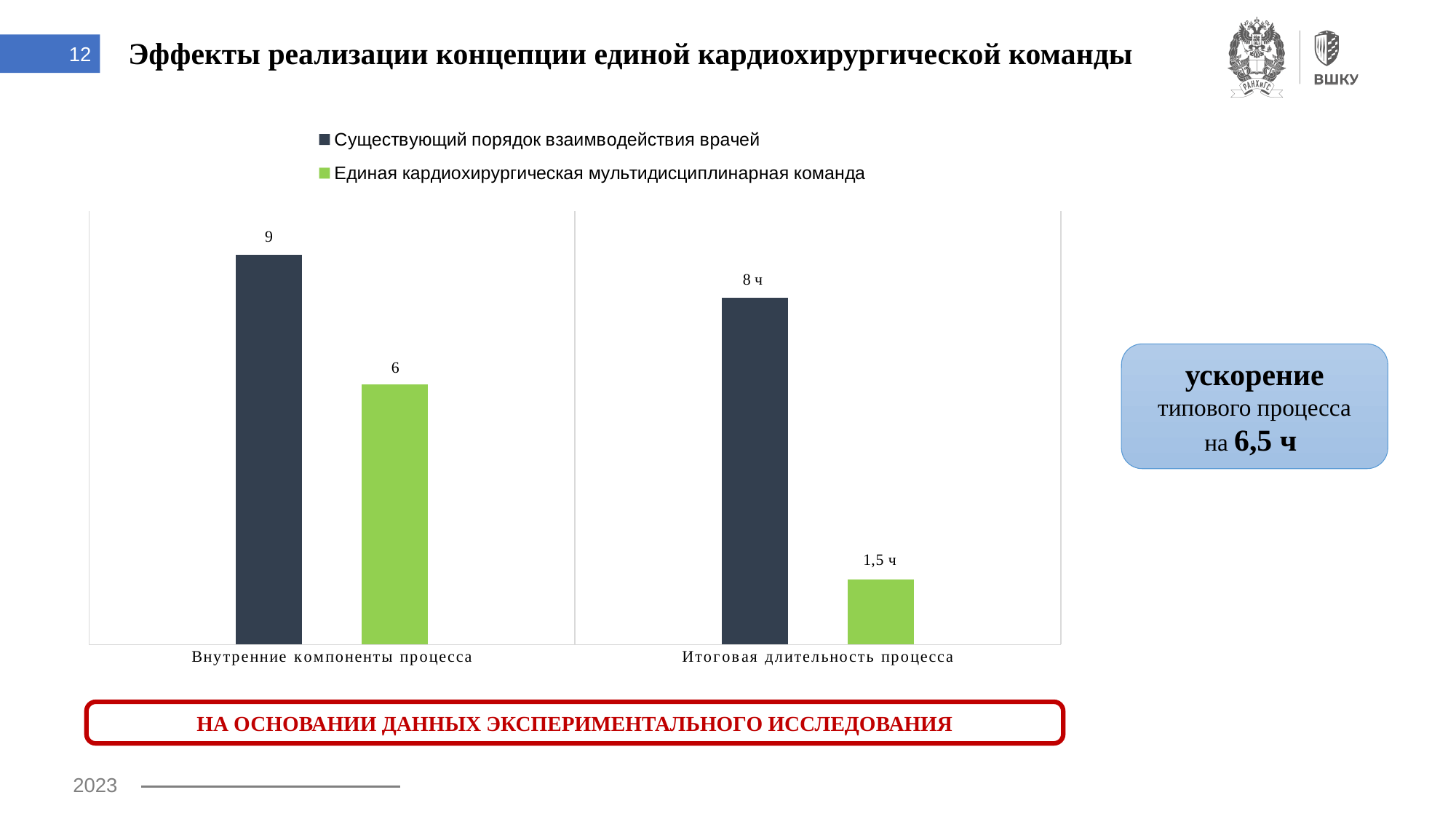
What is the value for "Единая кардиохирургическая мультидисциплинарная команда" in the category "Внутренние компоненты процесса"? 6 Which bar in the chart has the lowest value? Единая кардиохирургическая мультидисциплинарная команда, Итоговая длительность процесса What is the value for "Существующий порядок взаимодействия врачей" in the category "Итоговая длительность процесса"? 8 ч What kind of chart is shown on the slide? Bar chart How many categories are shown on the x axis of the chart? 2 How many series does the legend list? 2 Which bar in the chart has the highest value? Существующий порядок взаимодействия врачей, Внутренние компоненты процесса What is the difference between the two series in the category "Внутренние компоненты процесса"? 3 What is the value for "Единая кардиохирургическая мультидисциплинарная команда" in the category "Итоговая длительность процесса"? 1,5 ч What is the value for "Существующий порядок взаимодействия врачей" in the category "Внутренние компоненты процесса"? 9 In the category "Итоговая длительность процесса", which series has the larger value? Существующий порядок взаимодействия врачей What is the difference between the two series in the category "Итоговая длительность процесса"? 6,5 ч